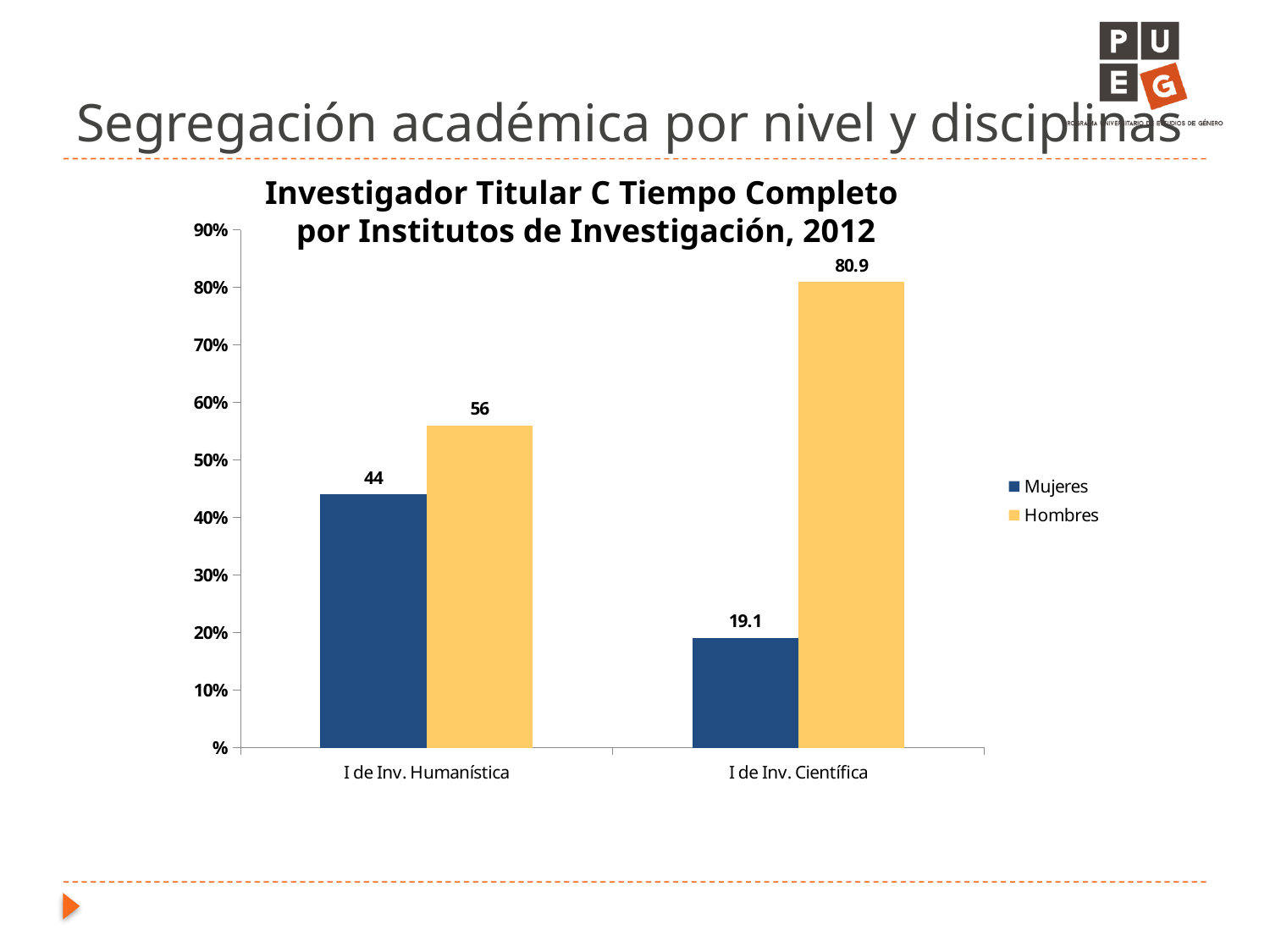
What is the value for Hombres at I de Inv. Científica? 80.9 Which is larger at I de Inv. Humanística, Mujeres or Hombres? Hombres What is the difference between Hombres and Mujeres at I de Inv. Humanística? 12 What is the value for Mujeres at I de Inv. Humanística? 44 Which category has the lowest value for Mujeres? I de Inv. Científica Which category has the highest value for Hombres? I de Inv. Científica What is the value for Hombres at I de Inv. Humanística? 56 How many categories are shown on the x axis? 2 What is the value for Mujeres at I de Inv. Científica? 19.1 What is the difference between Hombres and Mujeres at I de Inv. Científica? 61.8 What kind of chart is shown on the slide? Bar chart How many series does the legend list? 2